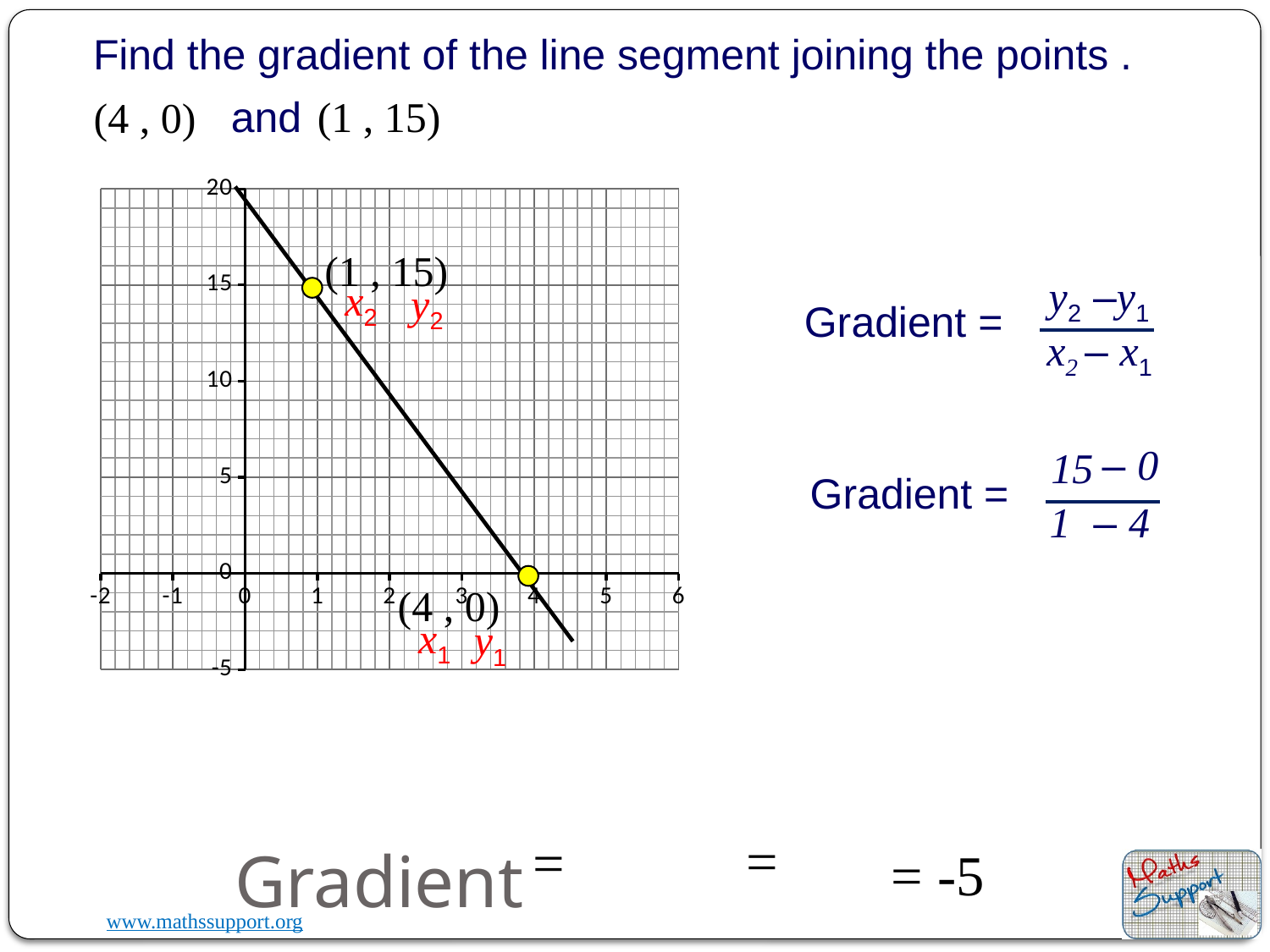
How many points are marked on the line in the chart? 2 Does the line rise or fall as x increases? fall Which marked point has the highest y-value? (1, 15) Which marked point has the lowest y-value? (4, 0) What is the y-value of the marked point at x = 4? 0 What is the gradient of the line segment, as stated on the slide? -5 What is the y-value of the marked point at x = 1? 15 What is the difference between the y-values of the two marked points? 15 What colour are the two marked points on the line? yellow Which marked point has the higher y-value, (1, 15) or (4, 0)? (1, 15) What kind of chart is shown on the slide? line chart Is the y-value where the line crosses the y-axis greater or less than 15? greater